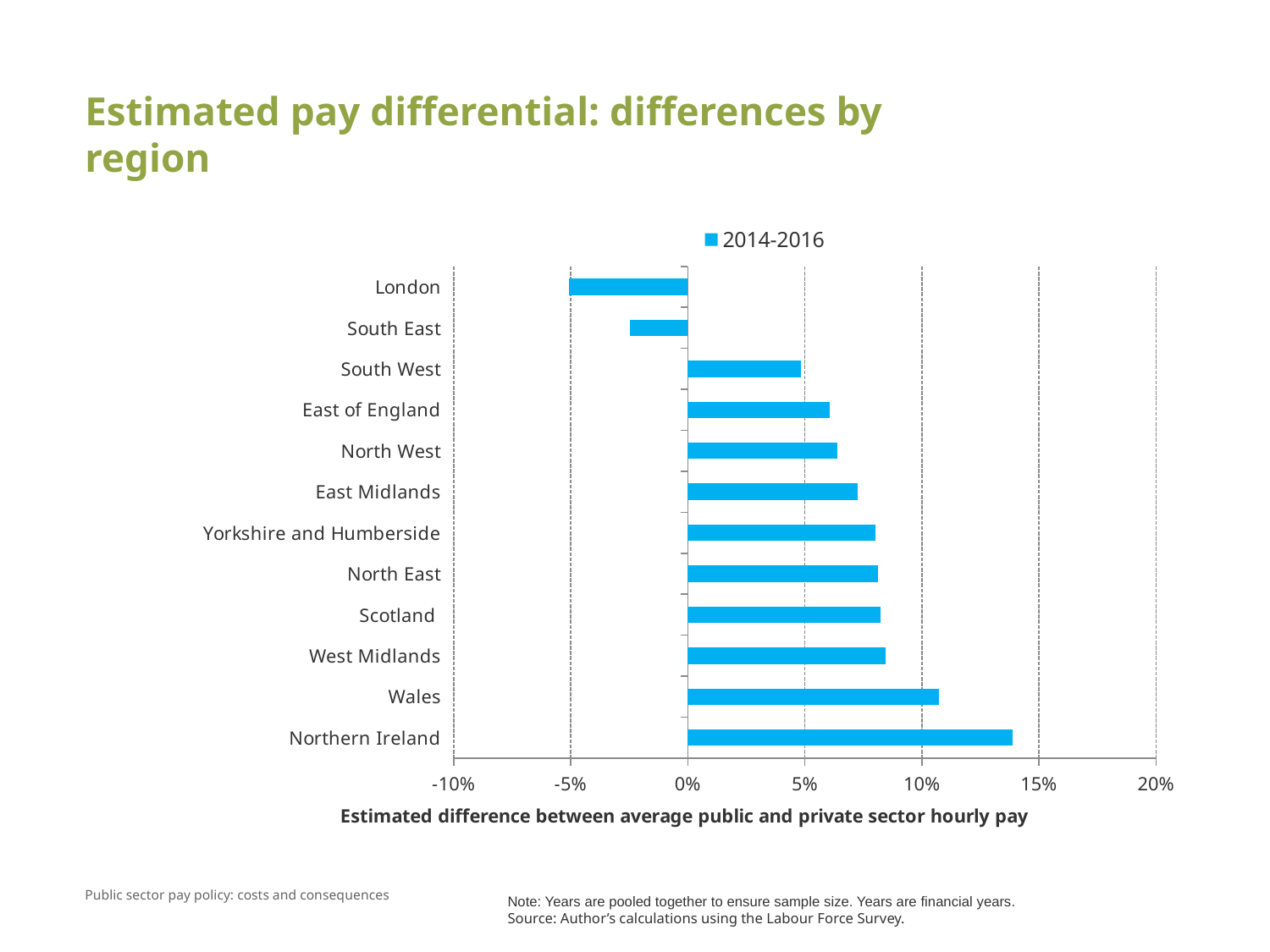
Which has the larger value, London or South East? South East Is the value for London greater or less than 0%? less Is the value for Northern Ireland greater or less than 10%? greater Which has the larger value, Wales or Northern Ireland? Northern Ireland Is the value for East of England greater or less than 5%? greater What period does the legend entry refer to? 2014-2016 How many series does the legend list? 1 How many regions are plotted on the chart? 12 What kind of chart is shown on the slide? bar chart Which region has the highest estimated pay differential? Northern Ireland Which region has the lowest estimated pay differential? London